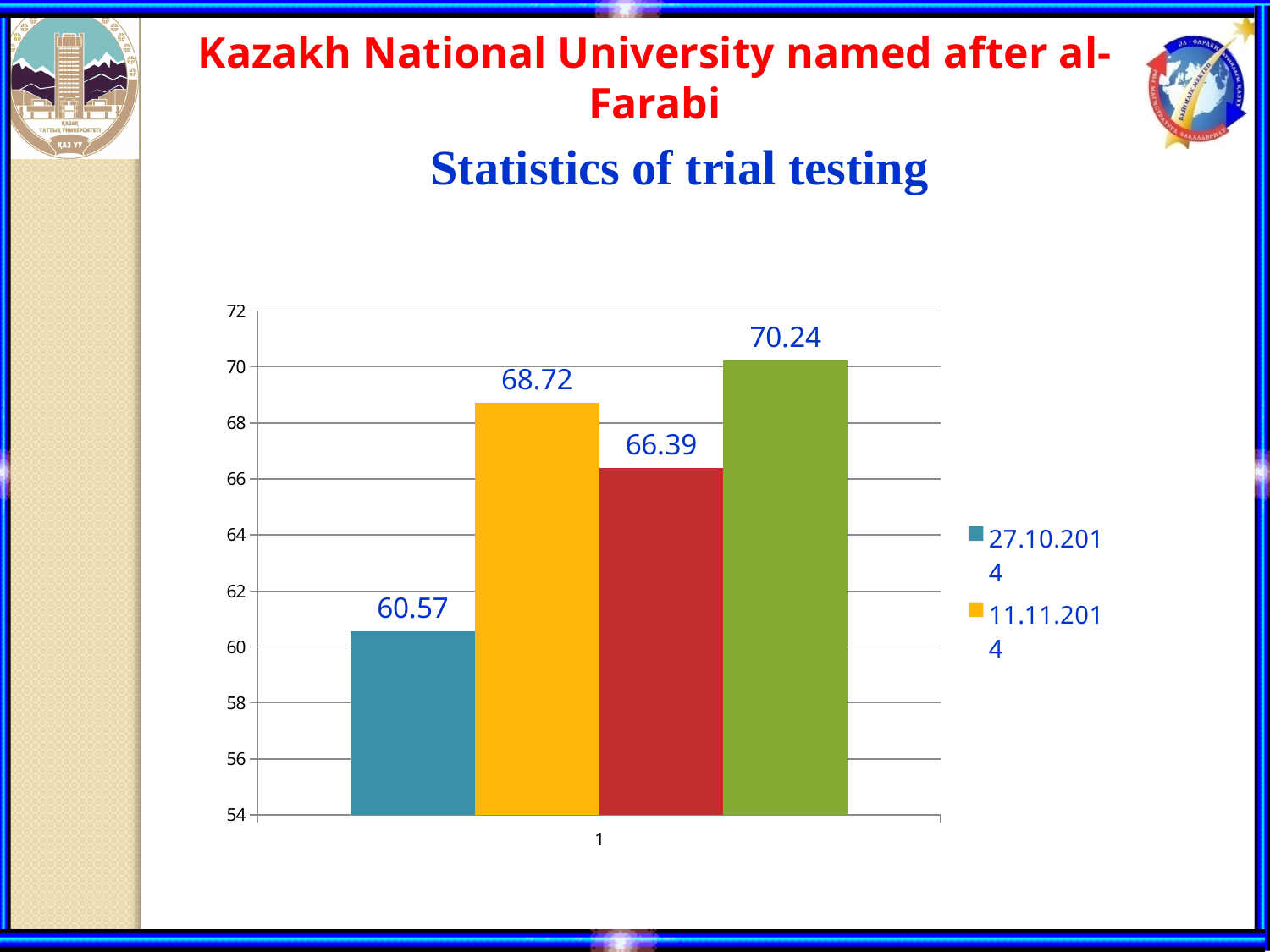
Which legend series has the lowest value? 27.10.2014 What is the value for the 11.11.2014 series? 68.72 What is the difference between the 11.11.2014 value and the 27.10.2014 value? 8.15 What is the highest value shown on the chart? 70.24 What is the value for the 27.10.2014 series? 60.57 Is the value for 27.10.2014 greater or less than 62? less What is the title of the chart? Statistics of trial testing Which is larger, the value for 27.10.2014 or the value for 11.11.2014? 11.11.2014 How many bars are plotted on the chart? 4 How many series entries are visible in the legend? 2 What kind of chart is shown on the slide? bar chart Is the value for 11.11.2014 greater or less than 66? greater